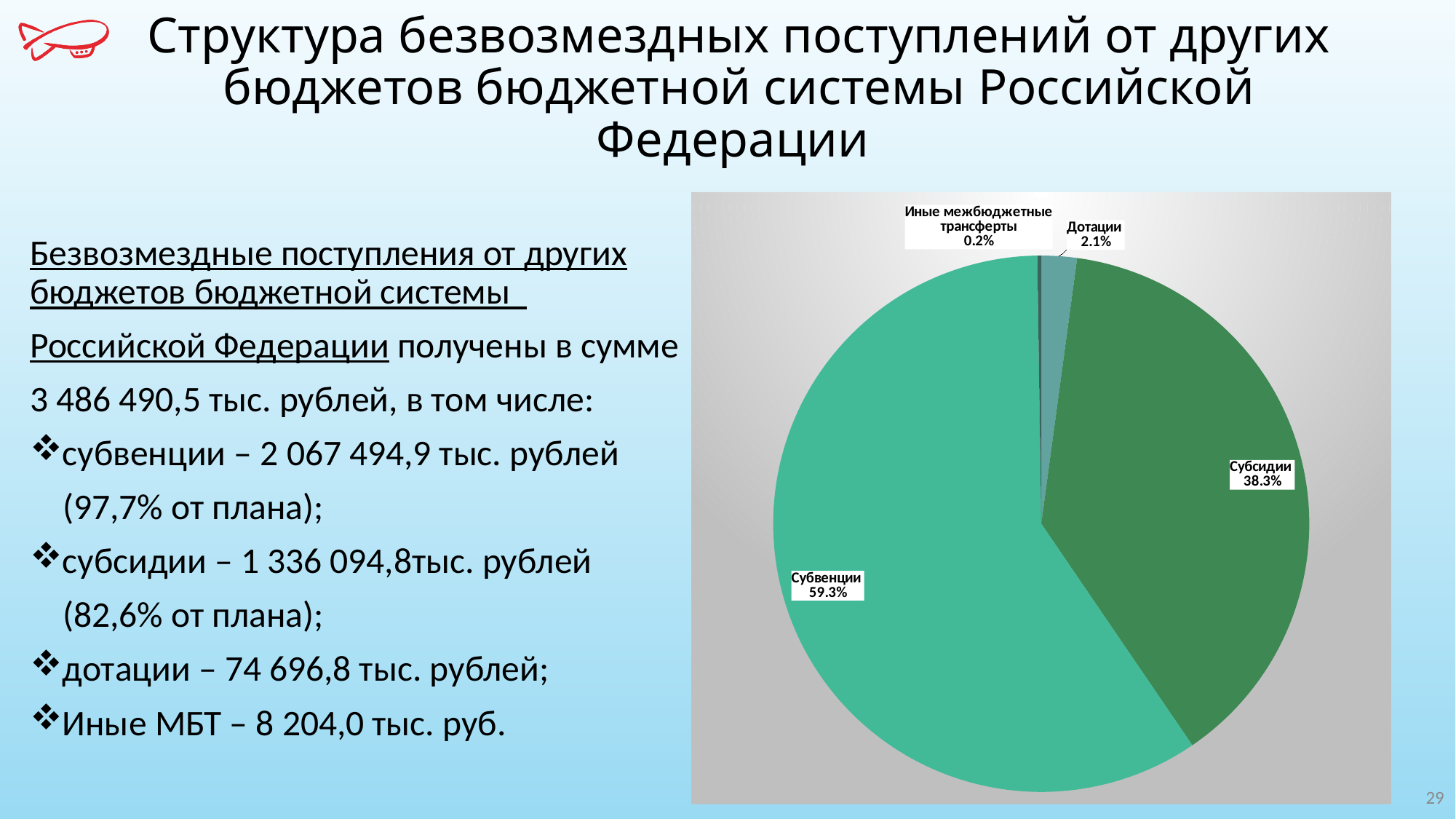
Which slice of the pie chart is the smallest? Иные межбюджетные трансферты What is the difference in percentage points between the Субвенции and Субсидии slices? 21.0% Which slice of the pie chart is the largest? Субвенции What kind of chart is shown on the slide? pie chart Which slice of the pie chart is shown in the darkest green colour? Субсидии What is the combined share of the Субвенции and Субсидии slices? 97.6% What share of the pie does Субвенции represent? 59.3% What share of the pie does Дотации represent? 2.1% What share of the pie does Иные межбюджетные трансферты represent? 0.2% Which is larger, the Дотации slice or the Иные межбюджетные трансферты slice? Дотации How many slices does the pie chart have? 4